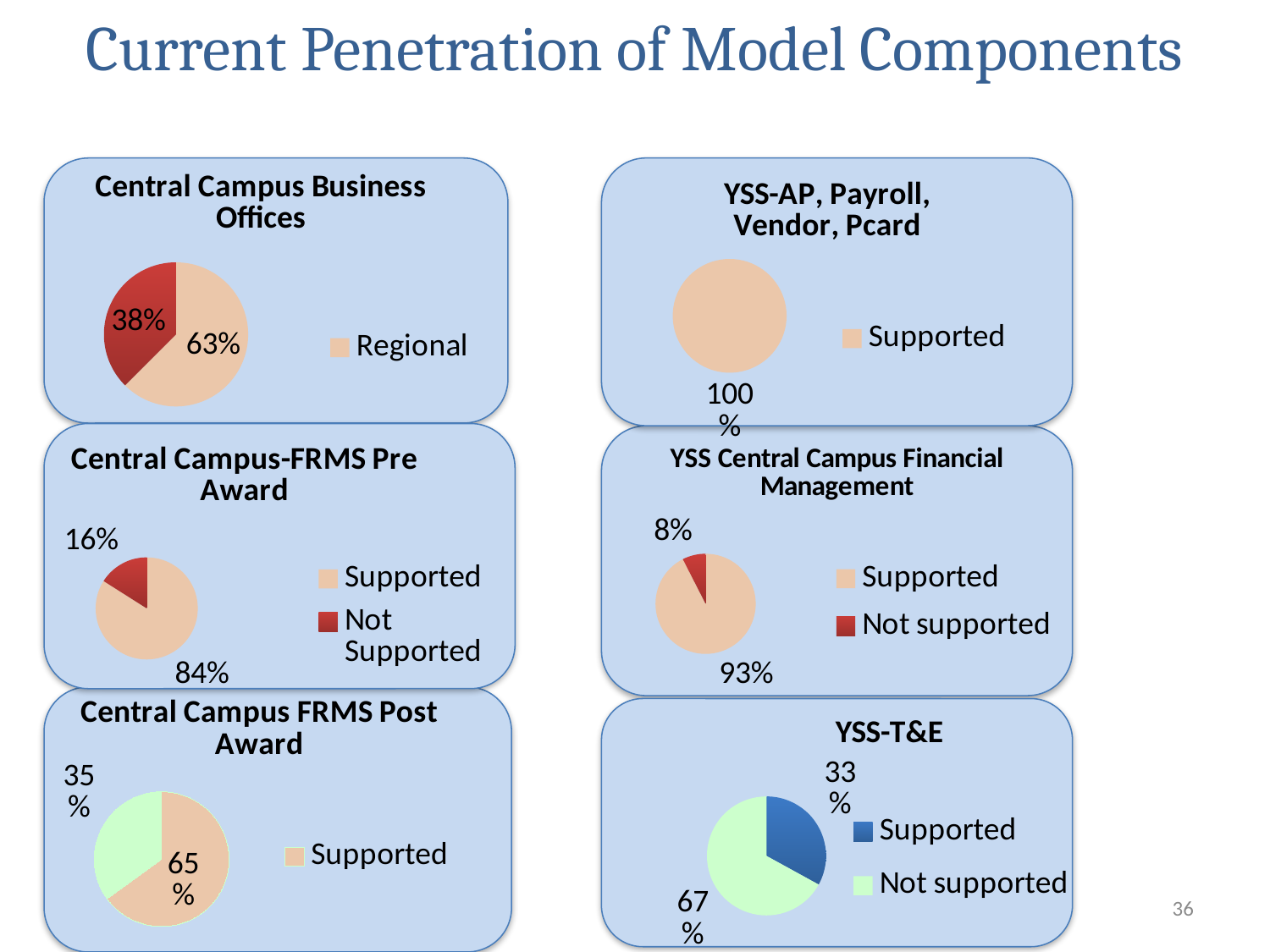
In the Central Campus-FRMS Pre Award chart, what percentage is Not Supported? 16% In the Central Campus-FRMS Pre Award chart, what percentage is Supported? 84% In the YSS Central Campus Financial Management chart, what percentage is Supported? 93% In the YSS-T&E chart, what percentage is Not supported? 67% In the YSS-T&E chart, which is larger, Supported or Not supported? Not supported What type of chart is used in the Central Campus FRMS Post Award box? Pie chart In the Central Campus-FRMS Pre Award chart, what is the difference between the Supported and Not Supported percentages? 68% In the Central Campus Business Offices chart, what percentage is labelled Regional? 63% In the YSS Central Campus Financial Management chart, what percentage is Not supported? 8% How many entries does the legend of the YSS Central Campus Financial Management chart list? 2 In the YSS-AP, Payroll, Vendor, Pcard chart, what percentage is Supported? 100% In the YSS-T&E chart, what percentage is Supported? 33%